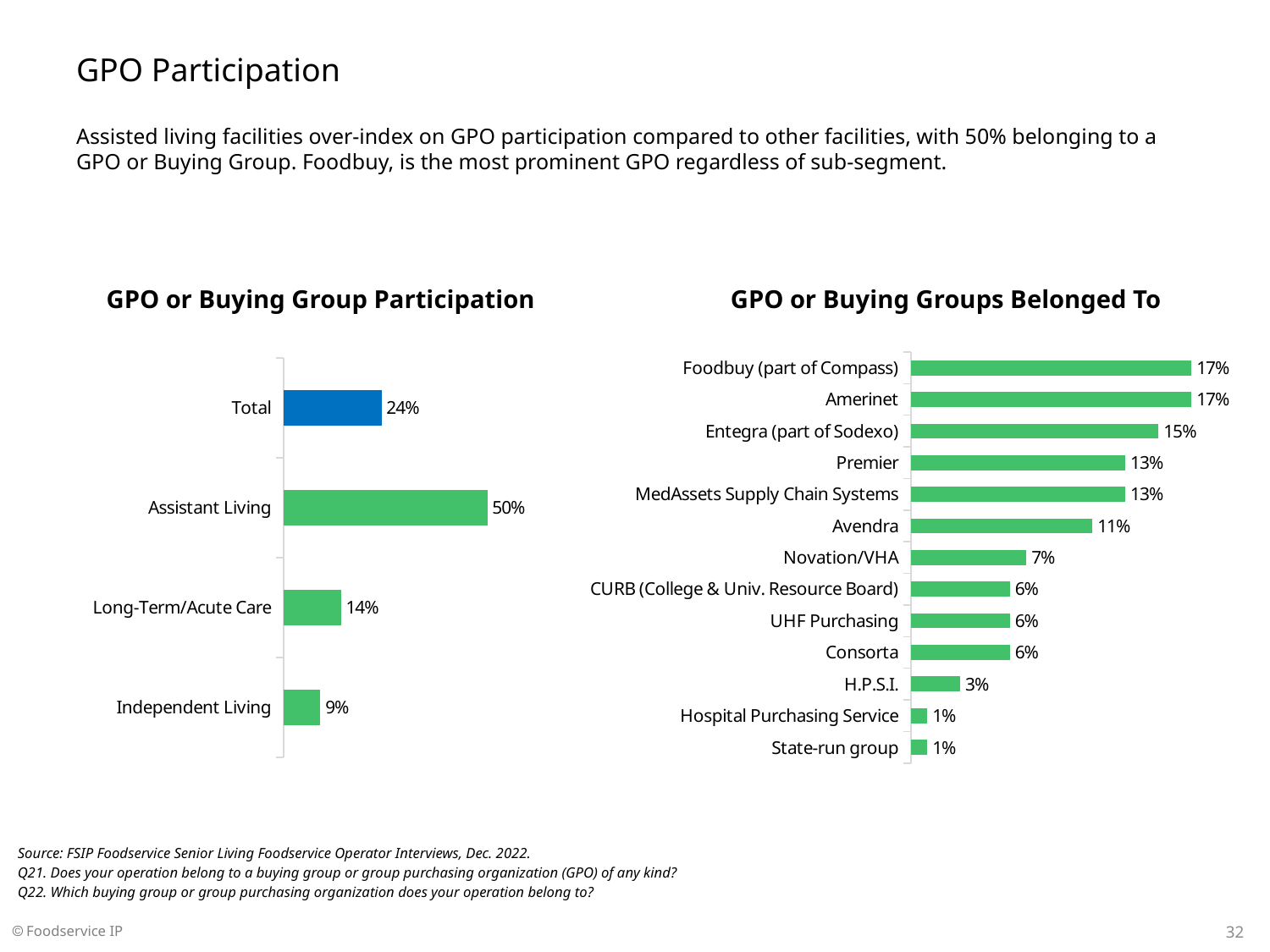
In the 'GPO or Buying Group Participation' chart, how many categories are shown? 4 In the 'GPO or Buying Group Participation' chart, which bar is coloured blue rather than green? Total In the 'GPO or Buying Groups Belonged To' chart, what is the difference between Foodbuy (part of Compass) and H.P.S.I.? 14% In the 'GPO or Buying Group Participation' chart, which category has the highest value? Assistant Living In the 'GPO or Buying Group Participation' chart, what is the value for Independent Living? 9% In the 'GPO or Buying Groups Belonged To' chart, what is the value for Entegra (part of Sodexo)? 15% In the 'GPO or Buying Groups Belonged To' chart, how many groups are listed? 13 In the 'GPO or Buying Group Participation' chart, what is the difference between Assistant Living and Long-Term/Acute Care? 36% In the 'GPO or Buying Groups Belonged To' chart, which is larger, Premier or Novation/VHA? Premier In the 'GPO or Buying Group Participation' chart, what is the value for Assistant Living? 50% In the 'GPO or Buying Groups Belonged To' chart, what is the value for Avendra? 11% What type of chart is the 'GPO or Buying Groups Belonged To' chart? Bar chart